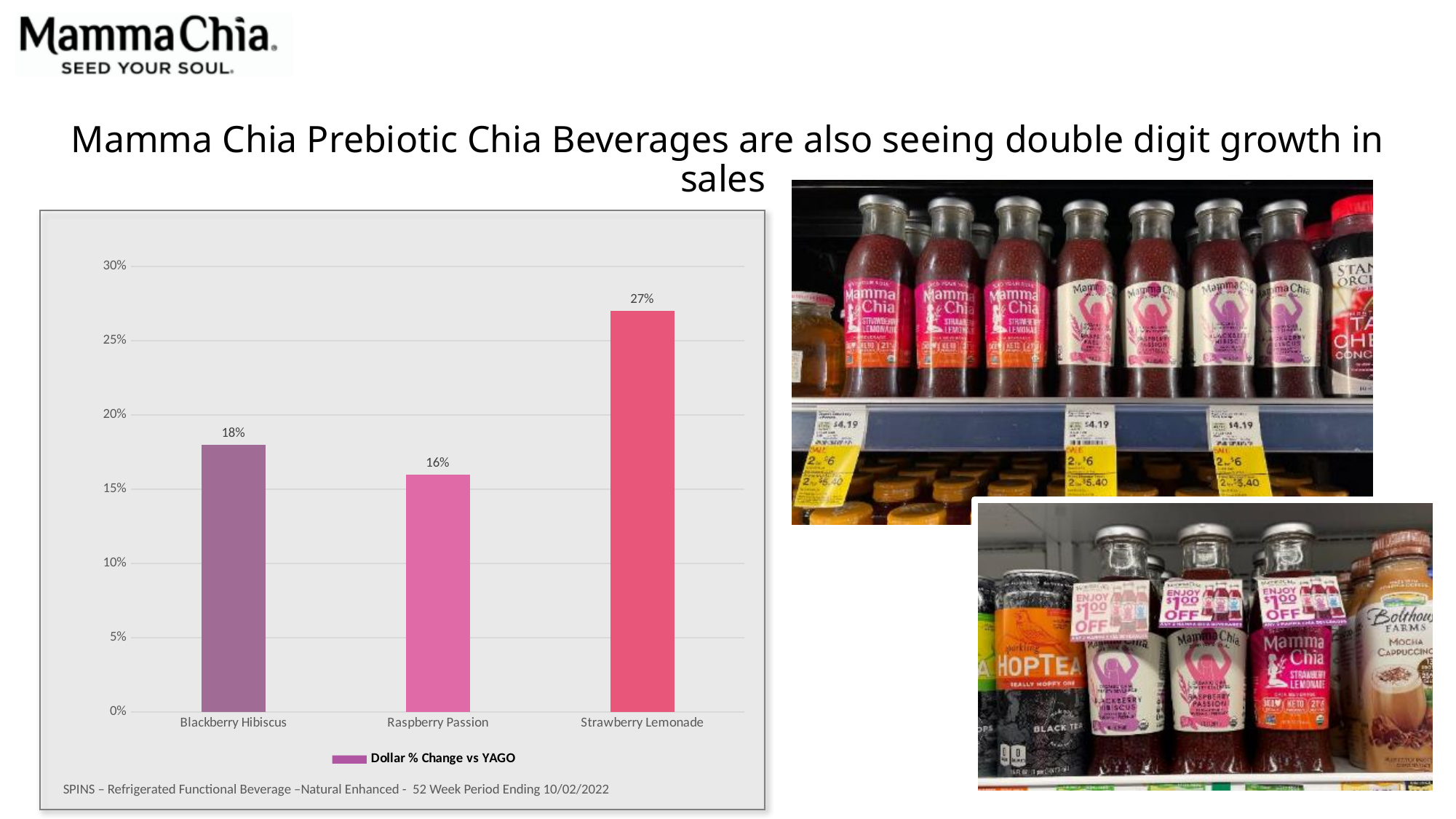
Which has a larger Dollar % Change vs YAGO, Blackberry Hibiscus or Strawberry Lemonade? Strawberry Lemonade Is the value for Strawberry Lemonade greater or less than 25%? greater What series name does the chart legend show? Dollar % Change vs YAGO What is the Dollar % Change vs YAGO for Blackberry Hibiscus? 18% What is the Dollar % Change vs YAGO for Raspberry Passion? 16% What is the difference in Dollar % Change vs YAGO between Strawberry Lemonade and Raspberry Passion? 11% What is the difference in Dollar % Change vs YAGO between Blackberry Hibiscus and Raspberry Passion? 2% What is the Dollar % Change vs YAGO for Strawberry Lemonade? 27% Which flavor has the lowest Dollar % Change vs YAGO? Raspberry Passion What kind of chart is shown on the slide? Bar chart Which flavor has the highest Dollar % Change vs YAGO? Strawberry Lemonade How many flavors are shown on the chart? 3